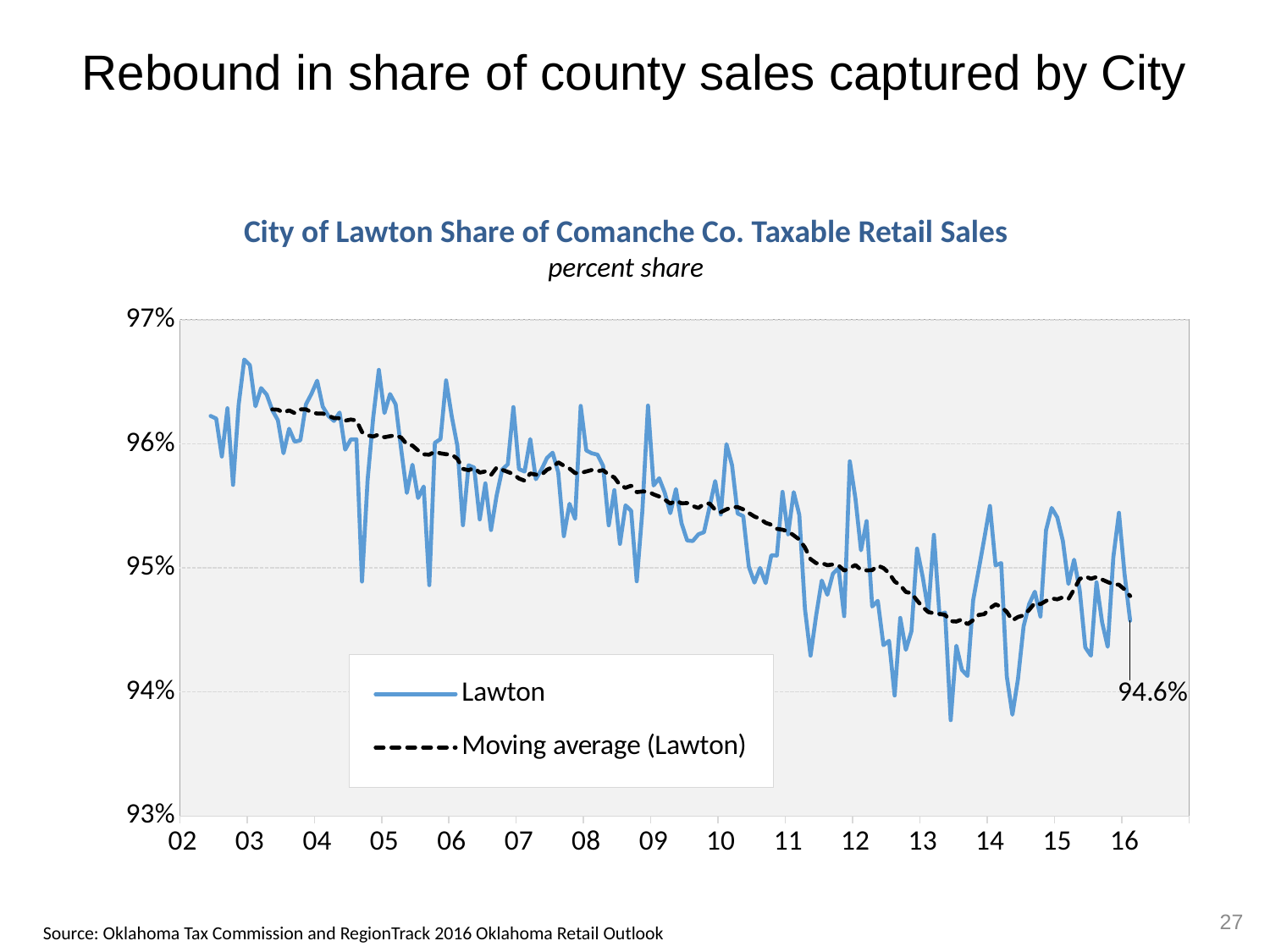
Is the lowest point of the Lawton line, around 2013, greater or less than 94%? less What is the highest value shown on the y axis? 97% What is the title of the chart? City of Lawton Share of Comanche Co. Taxable Retail Sales What are the two entries listed in the legend? Lawton; Moving average (Lawton) What kind of chart is shown on the slide? line chart Does the Lawton share of county taxable retail sales generally rise or fall from 2002 to 2016? fall How many year labels are shown on the x axis? 15 What is the labeled value of the Lawton line at the end of the series in 2016? 94.6% Is the moving average value at the end of the series in 2016 greater or less than 95%? less How many series does the legend list? 2 Is the Lawton share higher in 2003 or in 2016? 2003 Is the Lawton value at the start of the series in 2002 greater or less than 95%? greater